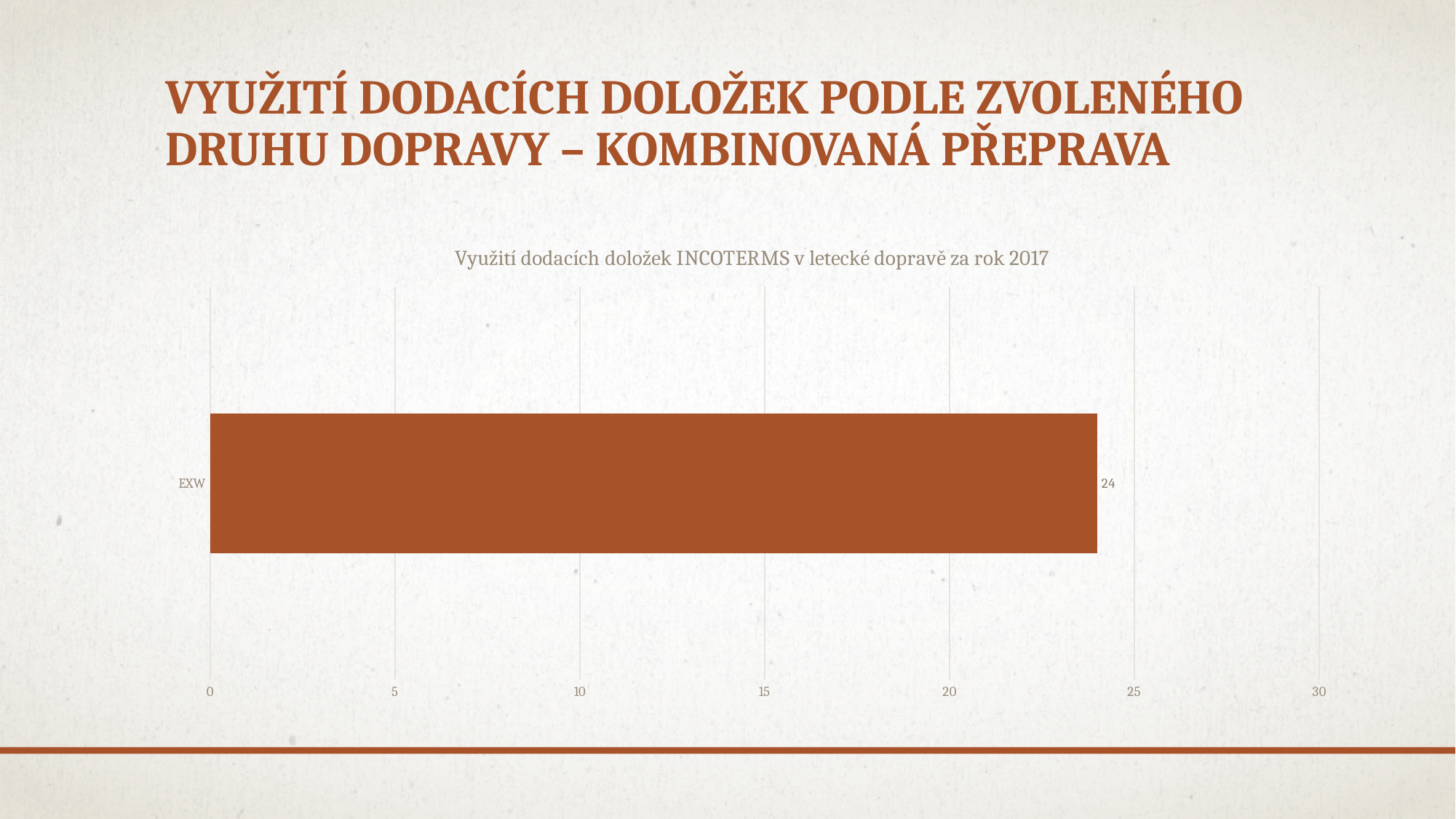
Is the value for EXW greater or less than 20? greater What is the title of the chart? Využití dodacích doložek INCOTERMS v letecké dopravě za rok 2017 Is the value for EXW greater or less than 25? less How many categories are plotted in the chart? 1 What is the value for EXW? 24 Which category has the highest value in the chart? EXW What is the highest value shown on the x axis? 30 What kind of chart is shown on the slide? bar chart